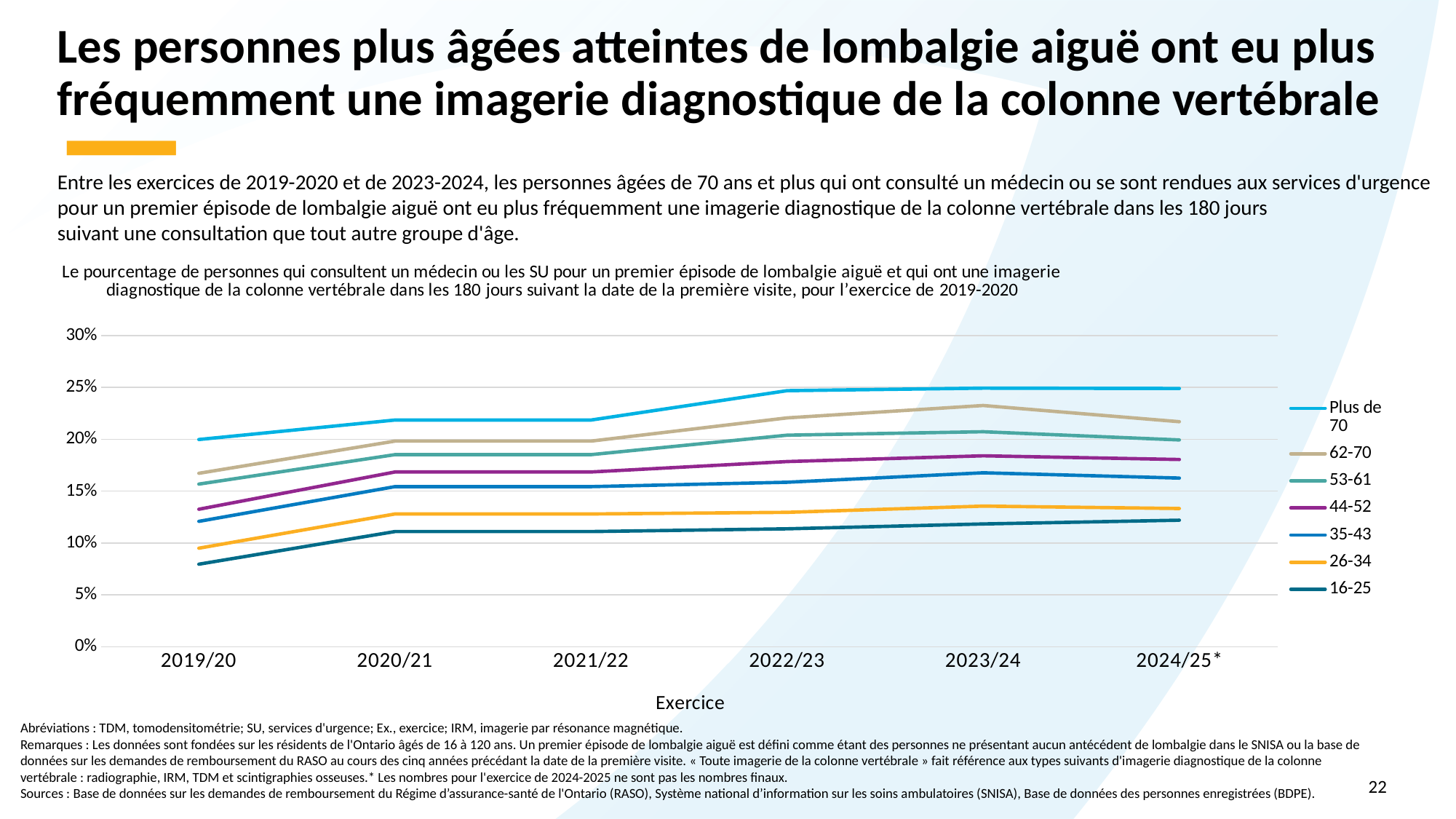
Does the value for Plus de 70 rise or fall from 2019/20 to 2023/24? rise What is the title of the x axis? Exercice Is the value for 44-52 in 2019/20 greater or less than 15%? less Which age group has the highest value in 2023/24? Plus de 70 What kind of chart is shown on the slide? line chart In 2022/23, which is larger: the value for 62-70 or the value for 53-61? 62-70 Is the value for Plus de 70 in 2023/24 greater or less than 20%? greater Is the value for 62-70 in 2023/24 greater or less than 20%? greater How many series does the legend list? 7 Which age group has the lowest value in 2019/20? 16-25 How many fiscal years (exercices) are shown on the x axis? 6